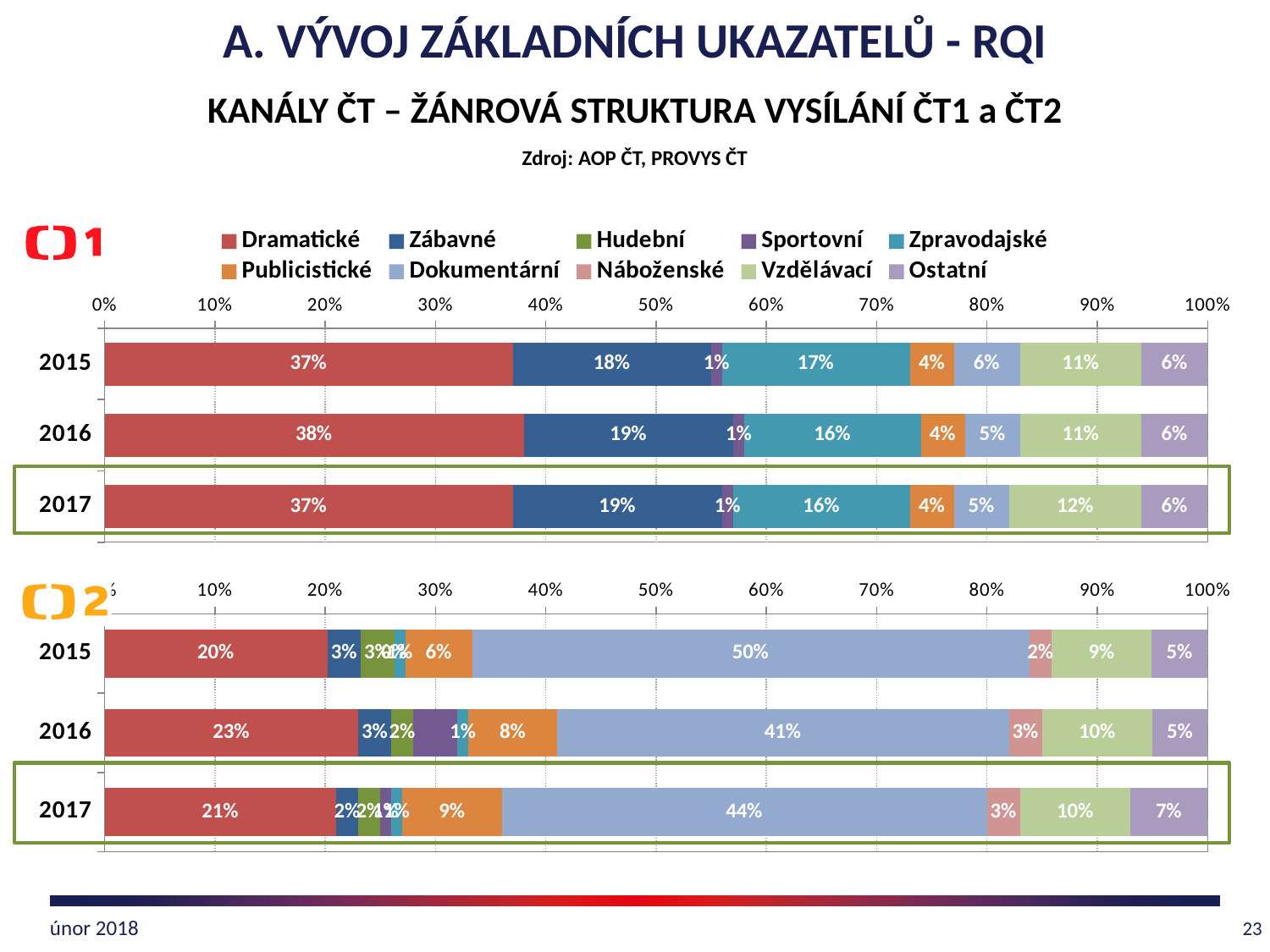
In the ČT1 chart (top), is the Dramatické share in 2016 larger or smaller than the Zábavné share in 2016? larger In the ČT1 chart (top), what is the value for Zpravodajské in 2017? 16% In the ČT1 chart (top), what is the value for Vzdělávací in 2017? 12% In the ČT2 chart (bottom), is the Dokumentární share in 2017 greater or less than 40%? greater What kind of chart is used on this slide? Stacked bar chart In the ČT1 chart (top), what is the value for Dramatické in 2015? 37% In the ČT2 chart (bottom), which genre has the largest share in 2016? Dokumentární In the ČT2 chart (bottom), what is the value for Dokumentární in 2015? 50% How many series does the legend list? 10 In the ČT2 chart (bottom), what is the value for Publicistické in 2017? 9% In the ČT2 chart (bottom), what is the difference between the Dokumentární share in 2015 and in 2016? 9% In the ČT1 chart (top), which genre has the largest share in 2017? Dramatické